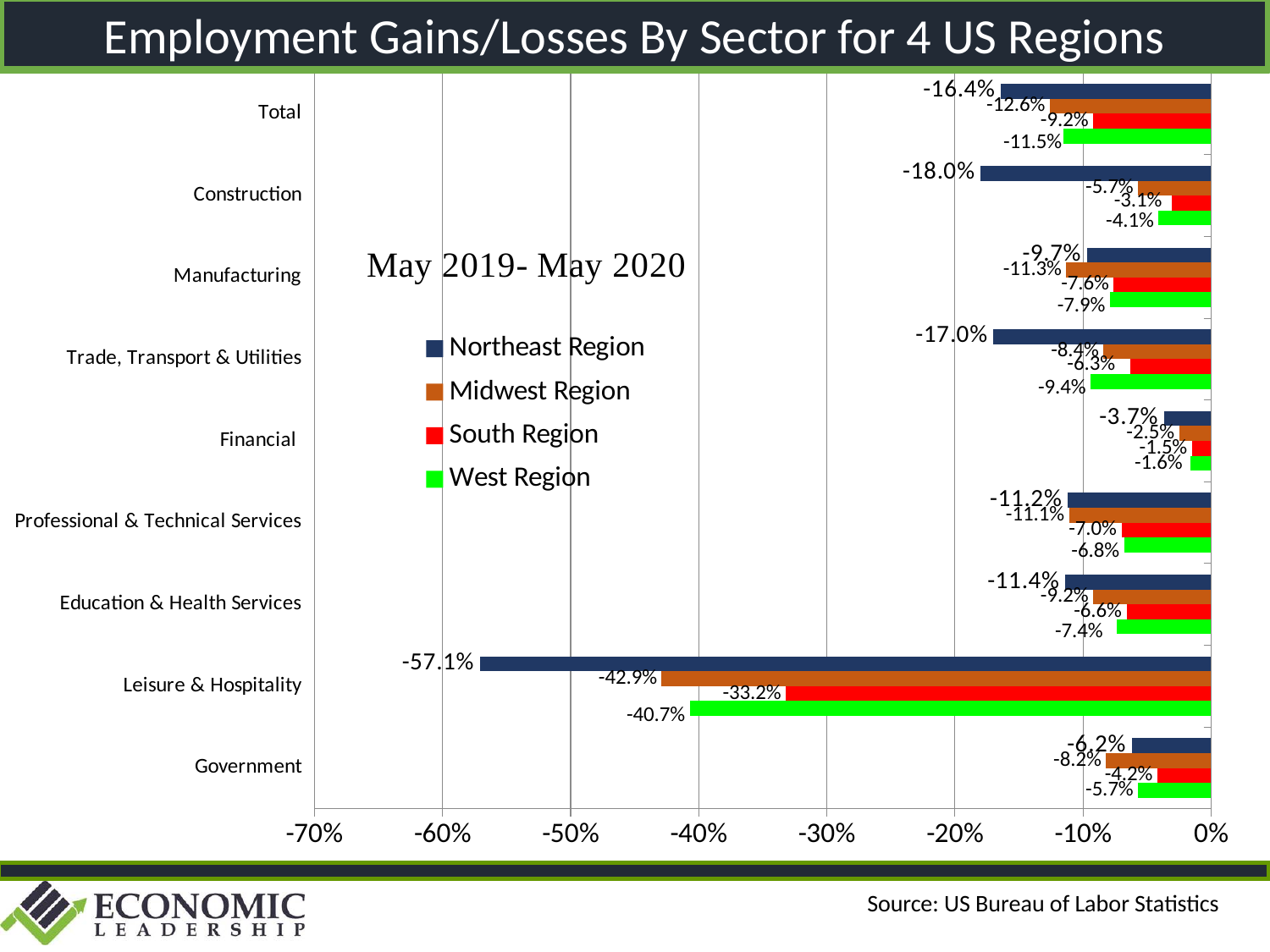
What is the value for the South Region in Construction? -3.1% What is the value for the Midwest Region in Government? -8.2% How many sectors are shown on the chart? 9 Which sector shows the largest employment loss for the Northeast Region? Leisure & Hospitality In Construction, which region has the larger employment loss, the Northeast Region or the Midwest Region? Northeast Region What time period does the chart cover, according to the text on the chart? May 2019 - May 2020 What is the difference between the Northeast Region and the South Region values in Leisure & Hospitality? 23.9 percentage points What is the value for the West Region in Total? -11.5% How many series does the legend list? 4 What kind of chart is shown on the slide? Bar chart Which sector shows the smallest employment loss for the South Region? Financial What is the value for the Northeast Region in Leisure & Hospitality? -57.1%